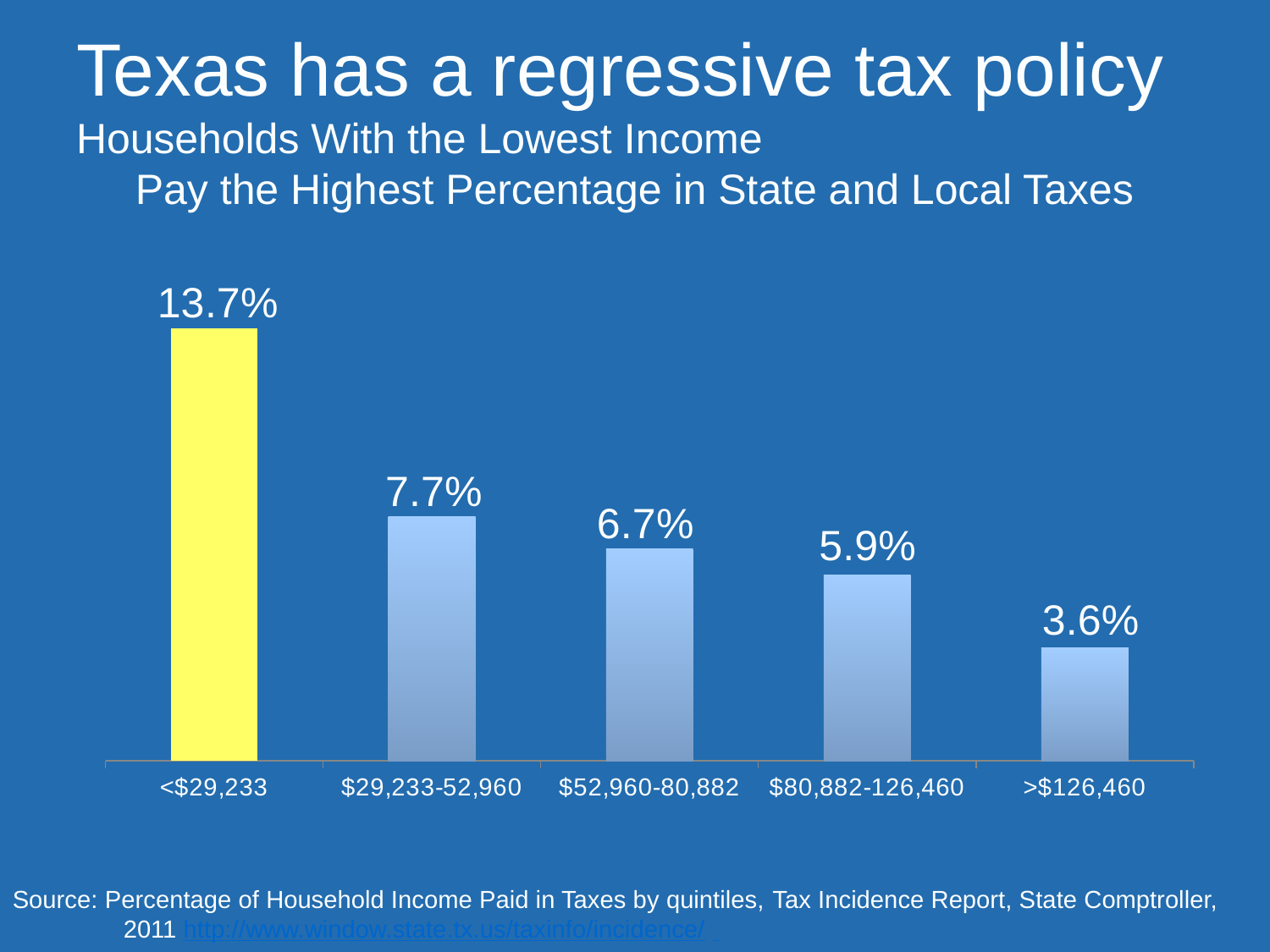
Which is larger, the value for $29,233-52,960 or the value for $80,882-126,460? $29,233-52,960 What percentage of income do households earning <$29,233 pay in state and local taxes? 13.7% What is the difference between the values for the $52,960-80,882 group and the >$126,460 group? 3.1% Which income group pays the lowest percentage in state and local taxes? >$126,460 What is the value for the $80,882-126,460 income group? 5.9% Do the values rise or fall as income increases along the x axis? Fall What is the difference between the values for the <$29,233 group and the $29,233-52,960 group? 6.0% How many income groups are shown in the chart? 5 What is the value for the $52,960-80,882 income group? 6.7% What kind of chart is shown on the slide? Bar chart Which income group pays the highest percentage in state and local taxes? <$29,233 What is the value for the >$126,460 income group? 3.6%